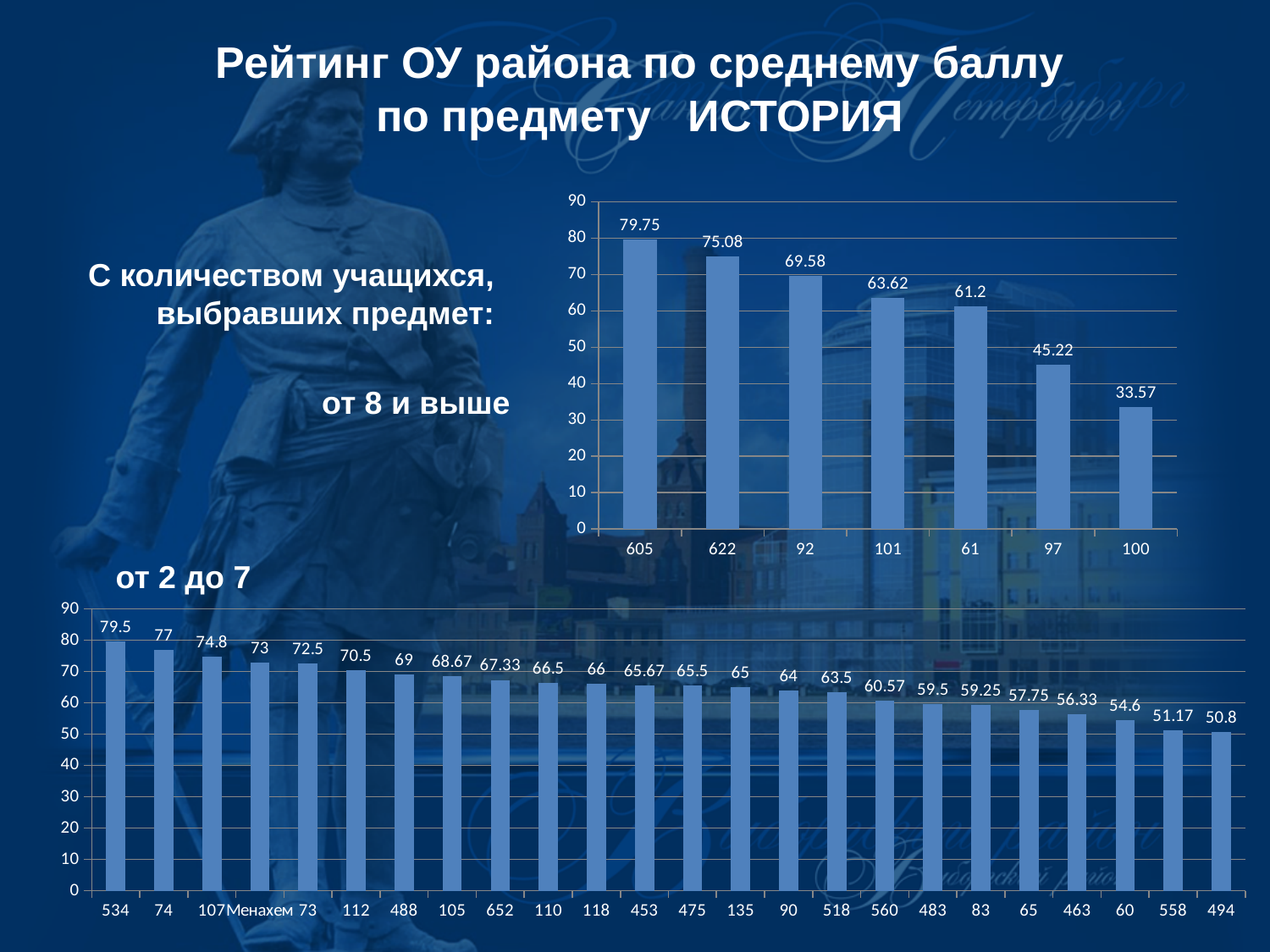
In the top-right chart (от 8 и выше), what is the value for category 605? 79.75 In the bottom chart (от 2 до 7), which is larger, the value for 560 or the value for 483? 560 In the bottom chart (от 2 до 7), how many categories are shown? 24 In the bottom chart (от 2 до 7), which category has the lowest value? 494 In the bottom chart (от 2 до 7), what is the value for category Менахем? 73 In the top-right chart (от 8 и выше), which category has the lowest value? 100 In the top-right chart (от 8 и выше), how many bars are there? 7 In the top-right chart (от 8 и выше), what is the value for category 97? 45.22 What type of chart is the bottom chart (от 2 до 7)? bar chart In the bottom chart (от 2 до 7), what is the value for category 534? 79.5 In the top-right chart (от 8 и выше), do the values rise or fall from left to right? fall In the top-right chart (от 8 и выше), what is the difference between the values for 605 and 622? 4.67